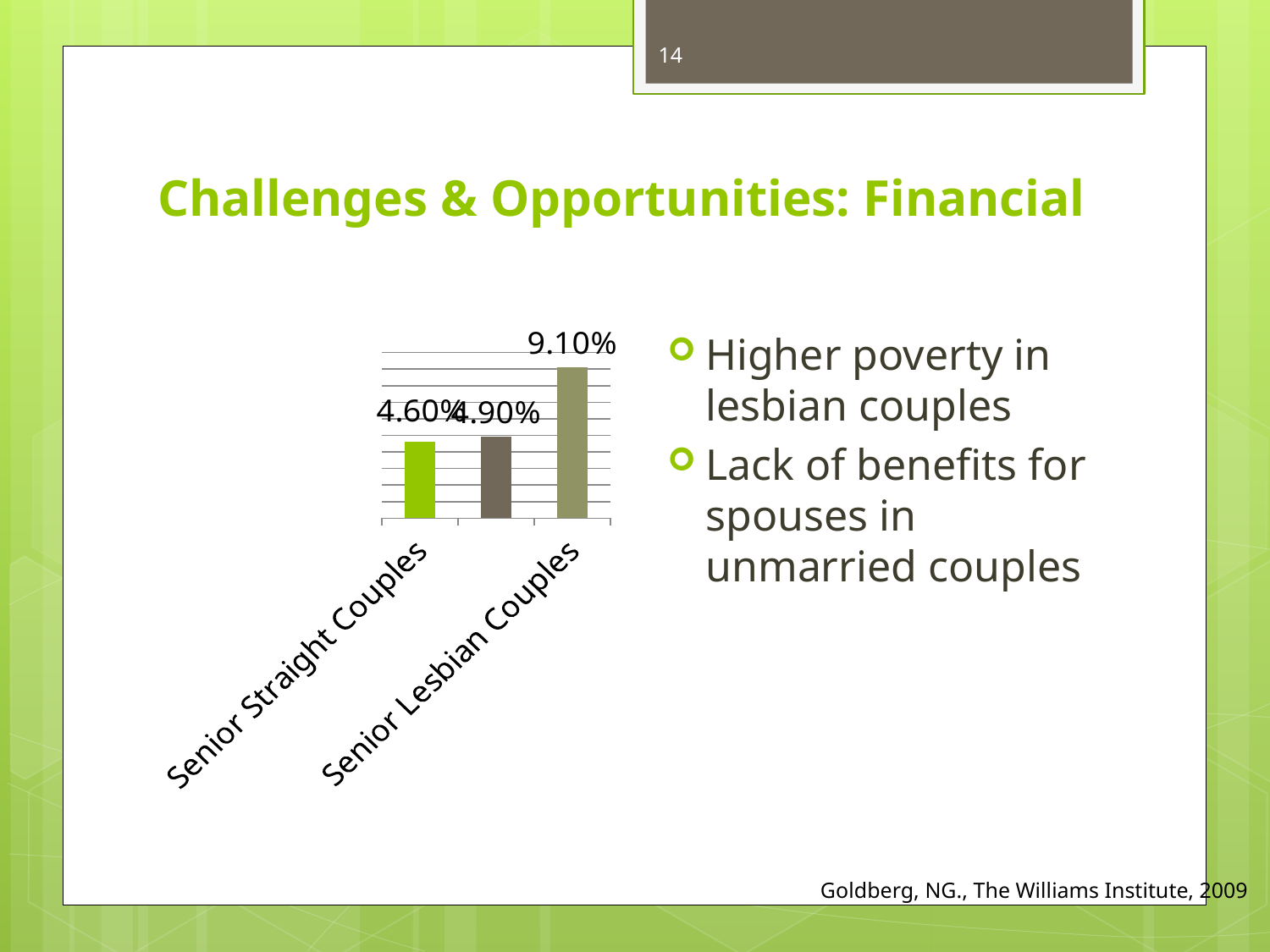
Which category has the lowest value in the chart? Senior Straight Couples Which is larger, the value for Senior Straight Couples or the value for Senior Lesbian Couples? Senior Lesbian Couples What value is shown for Senior Lesbian Couples? 9.10% Do the bar values rise or fall from left to right across the chart? Rise Which category has the highest value in the chart? Senior Lesbian Couples How many bars are plotted in the chart? 3 What value is shown for Senior Straight Couples? 4.60% What kind of chart is shown on the slide? Bar chart What colour is the bar for Senior Straight Couples? Green What is the difference between the value on the middle bar and the value for Senior Straight Couples? 0.30% What value is labelled on the middle bar of the chart? 4.90% What is the difference between the values for Senior Lesbian Couples and Senior Straight Couples? 4.50%